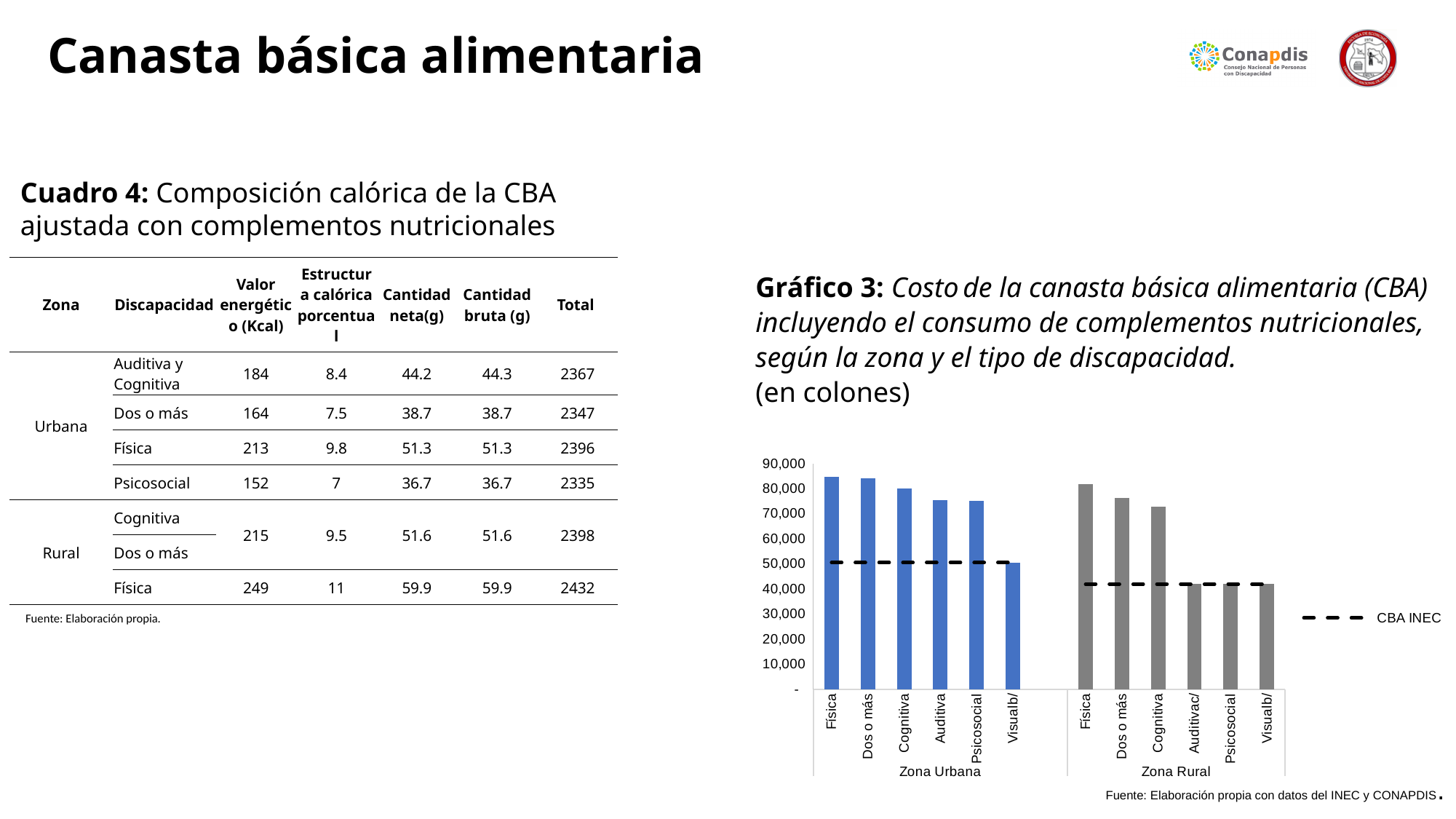
In Gráfico 3, what does the dashed line in the legend represent? CBA INEC In Gráfico 3, is the value for Visualb/ in Zona Urbana greater or less than 60,000? less In Gráfico 3, which disability type has the lowest bar in the Zona Urbana group? Visualb/ In Gráfico 3, do the bars in the Zona Urbana group rise or fall from left to right? fall In Gráfico 3, which is larger: the Cognitiva bar in Zona Urbana or the Cognitiva bar in Zona Rural? Zona Urbana In Gráfico 3, which disability type has the highest bar in the Zona Rural group? Física In Gráfico 3, how many bars are plotted in the Zona Urbana group? 6 What kind of chart is Gráfico 3? combination bar and line chart In Gráfico 3, how many bars are plotted in total across both zones? 12 In Gráfico 3, is the value for Física in Zona Urbana greater or less than 80,000? greater In Gráfico 3, is the value for Auditivac/ in Zona Rural greater or less than 50,000? less